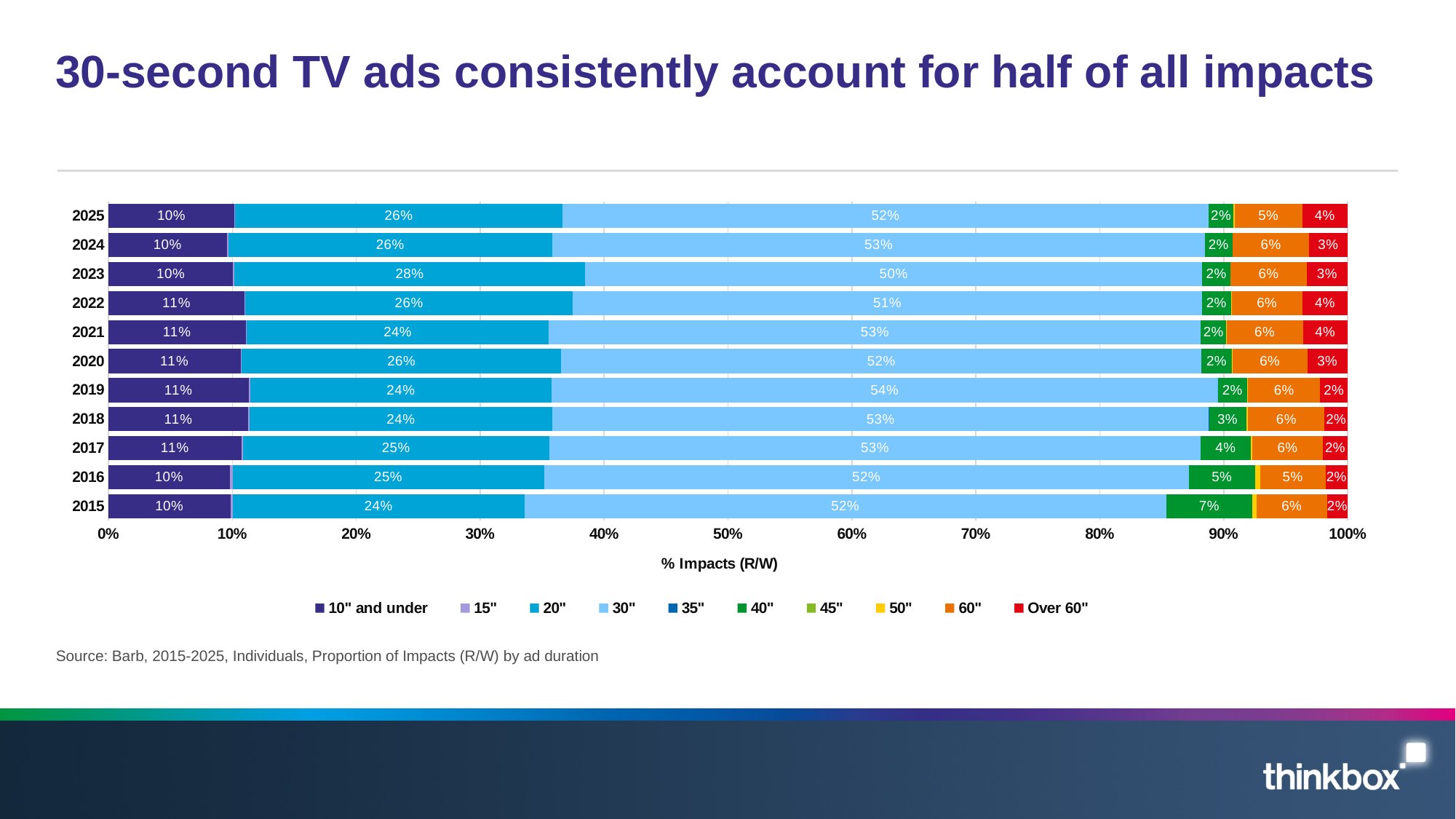
What was the share of impacts for 20" ads in 2023? 28% What percentage of impacts did 30" ads account for in 2025? 52% In which year did 30" ads have the lowest share of impacts? 2023 In which year did 30" ads have the highest share of impacts? 2019 What was the share for Over 60" ads in 2022? 4% Which year had the larger share for 20" ads, 2023 or 2021? 2023 What share of impacts did 40" ads have in 2015? 7% Did the share of impacts for 40" ads rise or fall from 2015 to 2025? Fall How many ad duration series does the legend list? 10 How many percentage points higher was the 30" share in 2019 than in 2023? 4 percentage points How many years are shown on the chart? 11 What type of chart is shown on the slide? Stacked bar chart